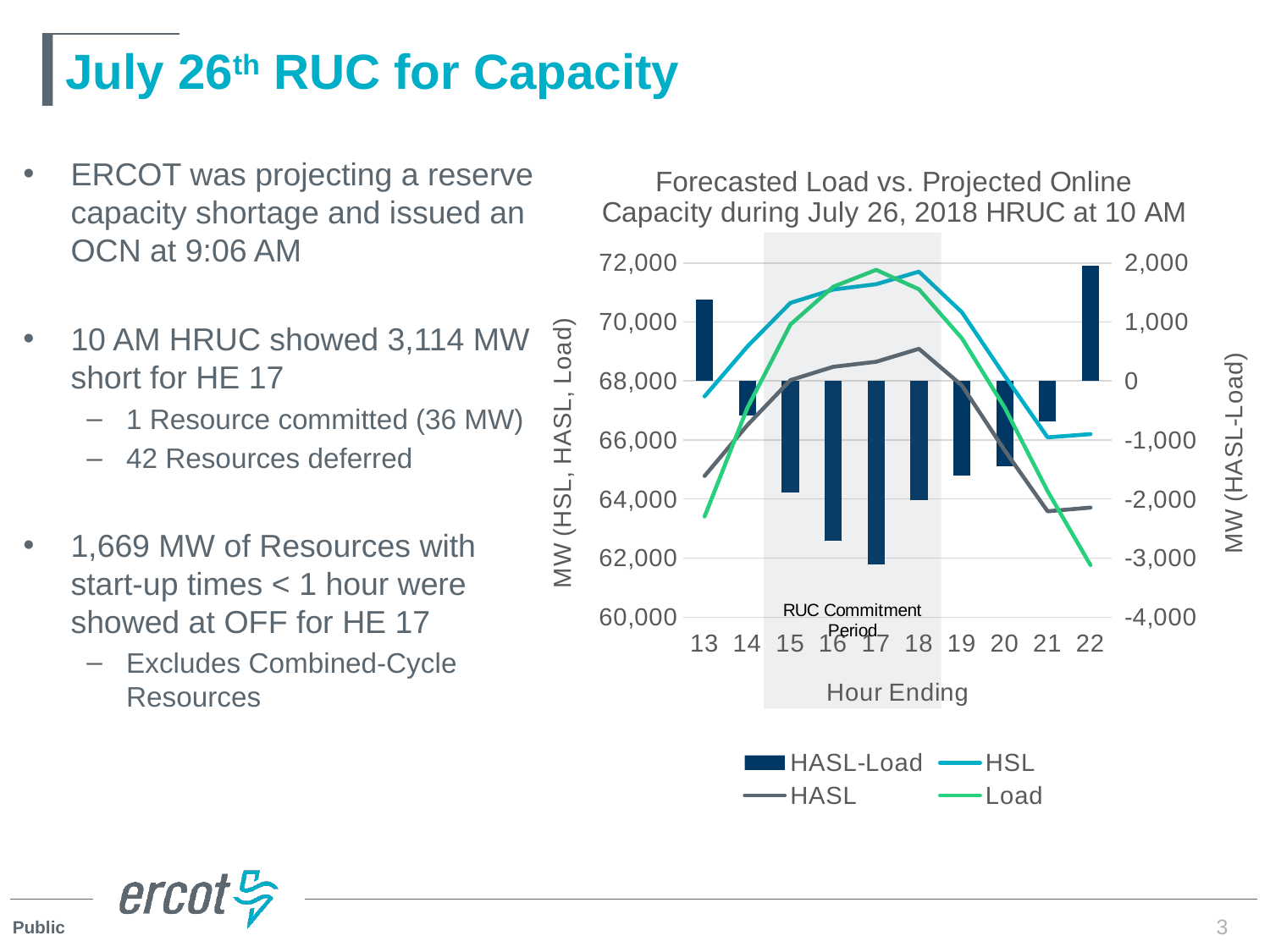
Is the HASL-Load value for hour ending 17 greater or less than -2,000? less How many series does the chart legend list? 4 Is the Load value for hour ending 17 greater or less than 70,000? greater At which hour ending does the Load line reach its peak? 17 Is the HASL-Load value for hour ending 22 greater or less than 1,000? greater Does the Load line rise or fall from hour ending 13 to hour ending 17? rise What label is shown on the shaded region of the chart? RUC Commitment Period Which is larger at hour ending 17, the Load value or the HASL value? Load At which hour ending is the HASL-Load bar lowest? 17 At which hour ending is the HASL-Load bar highest? 22 How many hour-ending categories are shown on the x axis? 10 What kind of chart is shown on the slide? A combination bar and line chart